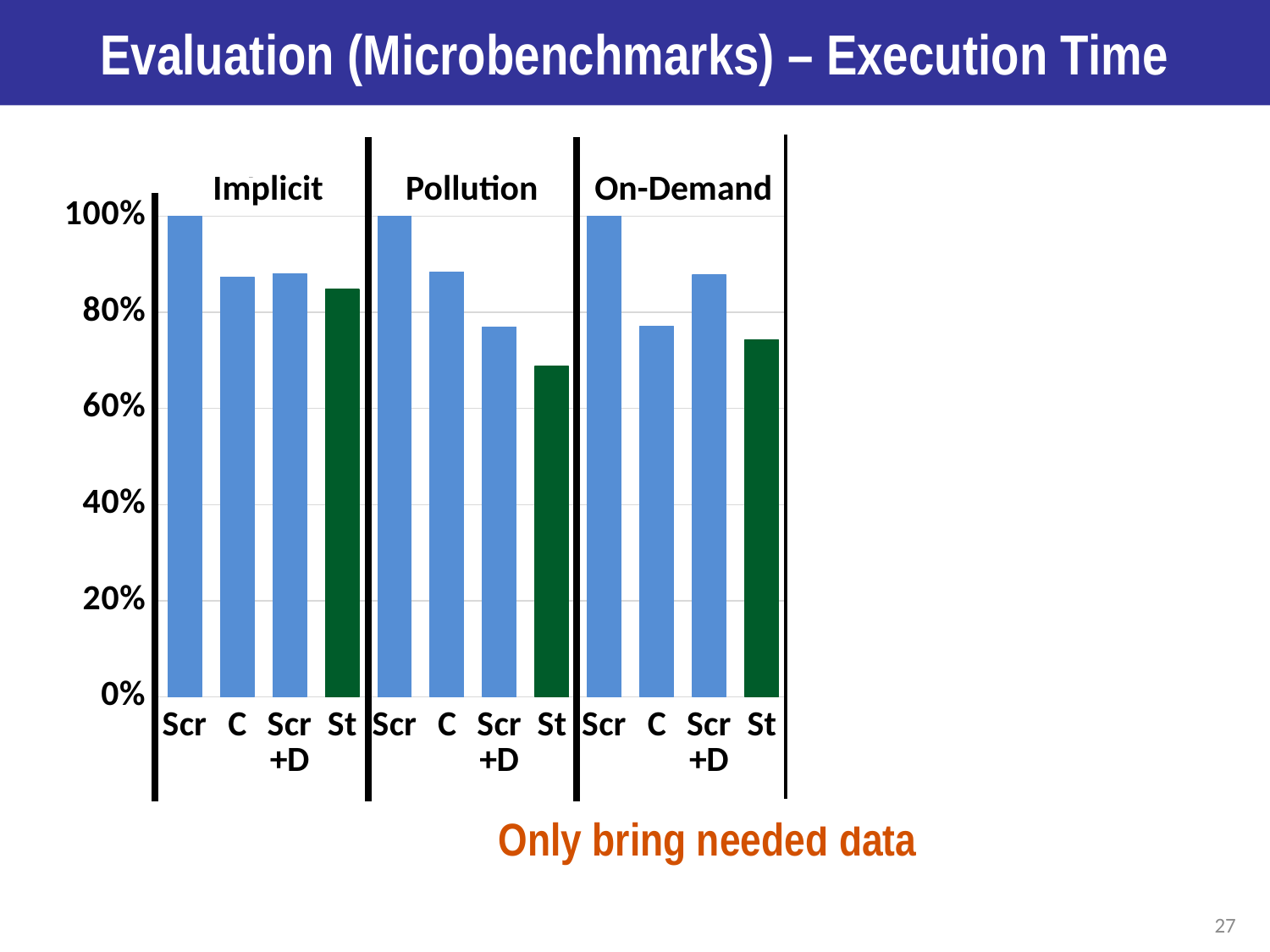
Which bar is the highest in the Implicit group? Scr Which is larger: Scr+D in the Pollution group or Scr+D in the On-Demand group? Scr+D in the On-Demand group What kind of chart is shown on the slide? bar chart Is the value for C in the On-Demand group greater or less than 80%? less What colour are the St bars in the chart? green How many groups of bars are shown in the chart? 3 What is the value of the Scr bar in the Pollution group? 100% What is the value of the Scr bar in the Implicit group? 100% How many bars are in the On-Demand group? 4 Is the value for C in the Implicit group greater or less than 80%? greater Is the value for St in the Pollution group greater or less than 80%? less Which bar is the lowest in the Pollution group? St